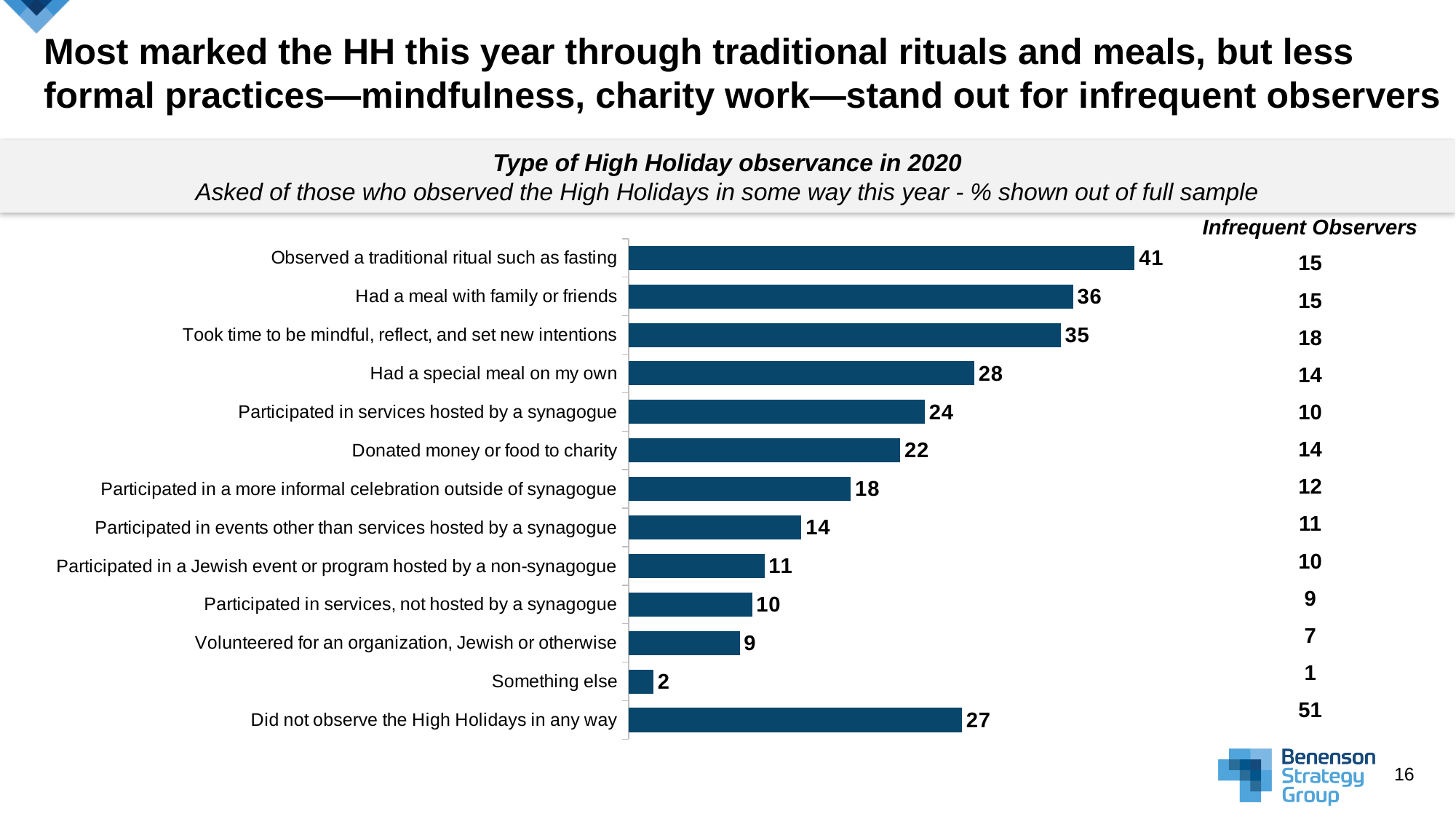
What is the Infrequent Observers value listed for "Took time to be mindful, reflect, and set new intentions"? 18 Which category has the lowest value in the bar chart? Something else What is the difference between the values for "Had a meal with family or friends" and "Had a special meal on my own"? 8 What value is shown for "Did not observe the High Holidays in any way"? 27 What is the Infrequent Observers value listed for "Did not observe the High Holidays in any way"? 51 What value is shown for "Donated money or food to charity"? 22 What is the title of the chart? Type of High Holiday observance in 2020 What kind of chart is shown on the slide? Bar chart Which is larger: the value for "Participated in services hosted by a synagogue" or "Participated in a more informal celebration outside of synagogue"? Participated in services hosted by a synagogue Which category has the highest value in the bar chart? Observed a traditional ritual such as fasting How many categories are plotted in the bar chart? 13 What value is shown for "Observed a traditional ritual such as fasting"? 41